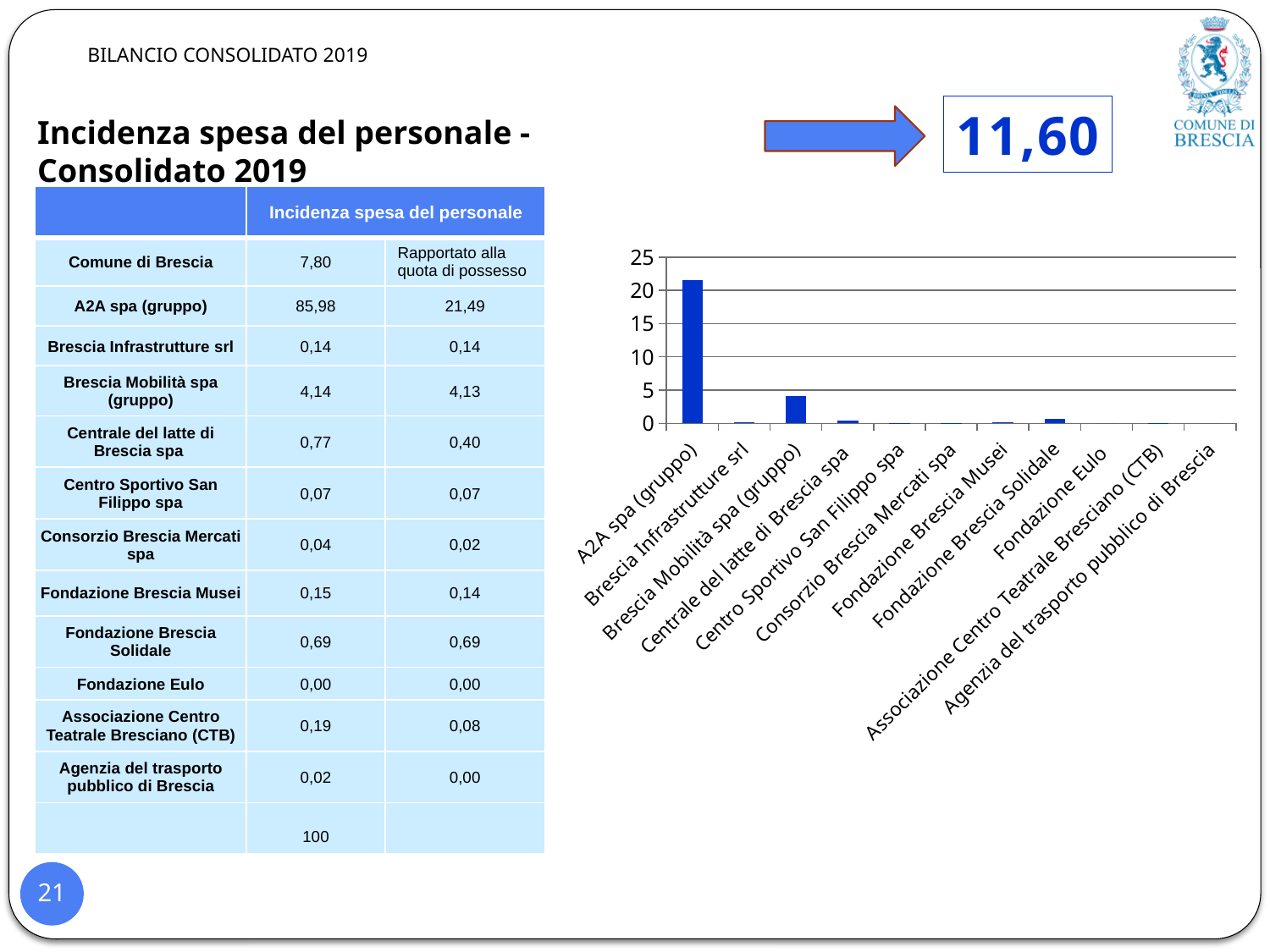
What is the highest value shown on the chart's vertical axis? 25 Which is larger, the bar for Brescia Mobilità spa (gruppo) or the bar for Fondazione Brescia Solidale? Brescia Mobilità spa (gruppo) Which category has the second-highest bar in the chart? Brescia Mobilità spa (gruppo) Is the value for A2A spa (gruppo) greater or less than 25? less What kind of chart is shown on the slide? bar chart Is the value for Fondazione Brescia Solidale greater or less than 5? less Is the value for A2A spa (gruppo) greater or less than 20? greater What number is shown in the highlighted box above the chart? 11,60 Which is larger, the bar for A2A spa (gruppo) or the bar for Brescia Mobilità spa (gruppo)? A2A spa (gruppo) Which category has the highest bar in the chart? A2A spa (gruppo) How many categories are plotted on the x axis of the chart? 11